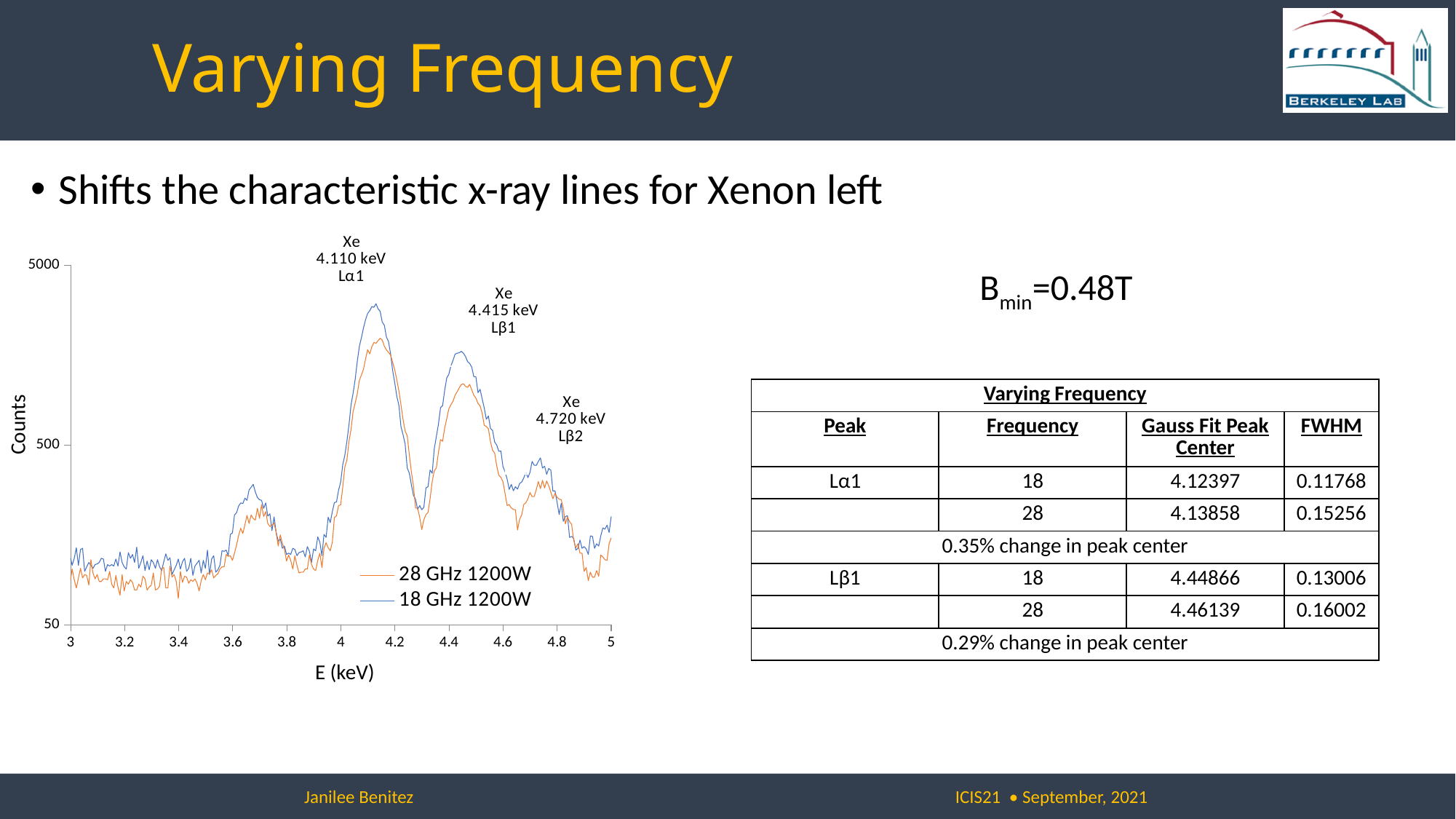
What energy is labelled on the chart for the Xe Lβ2 line? 4.720 keV Do the counts rise or fall as energy increases from 4.2 keV to 4.3 keV? fall What energy is labelled on the chart for the Xe Lβ1 line? 4.415 keV How many Xe x-ray lines are annotated on the chart? 3 How many series does the chart legend list? 2 Is the peak count of the 18 GHz 1200W series near 4.1 keV greater or less than 500? greater What are the two series named in the chart legend? 28 GHz 1200W and 18 GHz 1200W Is the count of the 28 GHz 1200W series at 3 keV greater or less than 500? less At the Lα1 peak near 4.1 keV, which series reaches higher counts, 28 GHz 1200W or 18 GHz 1200W? 18 GHz 1200W What is the label of the chart's x axis? E (keV) What energy is labelled on the chart for the Xe Lα1 line? 4.110 keV What kind of chart is shown on the slide? line chart